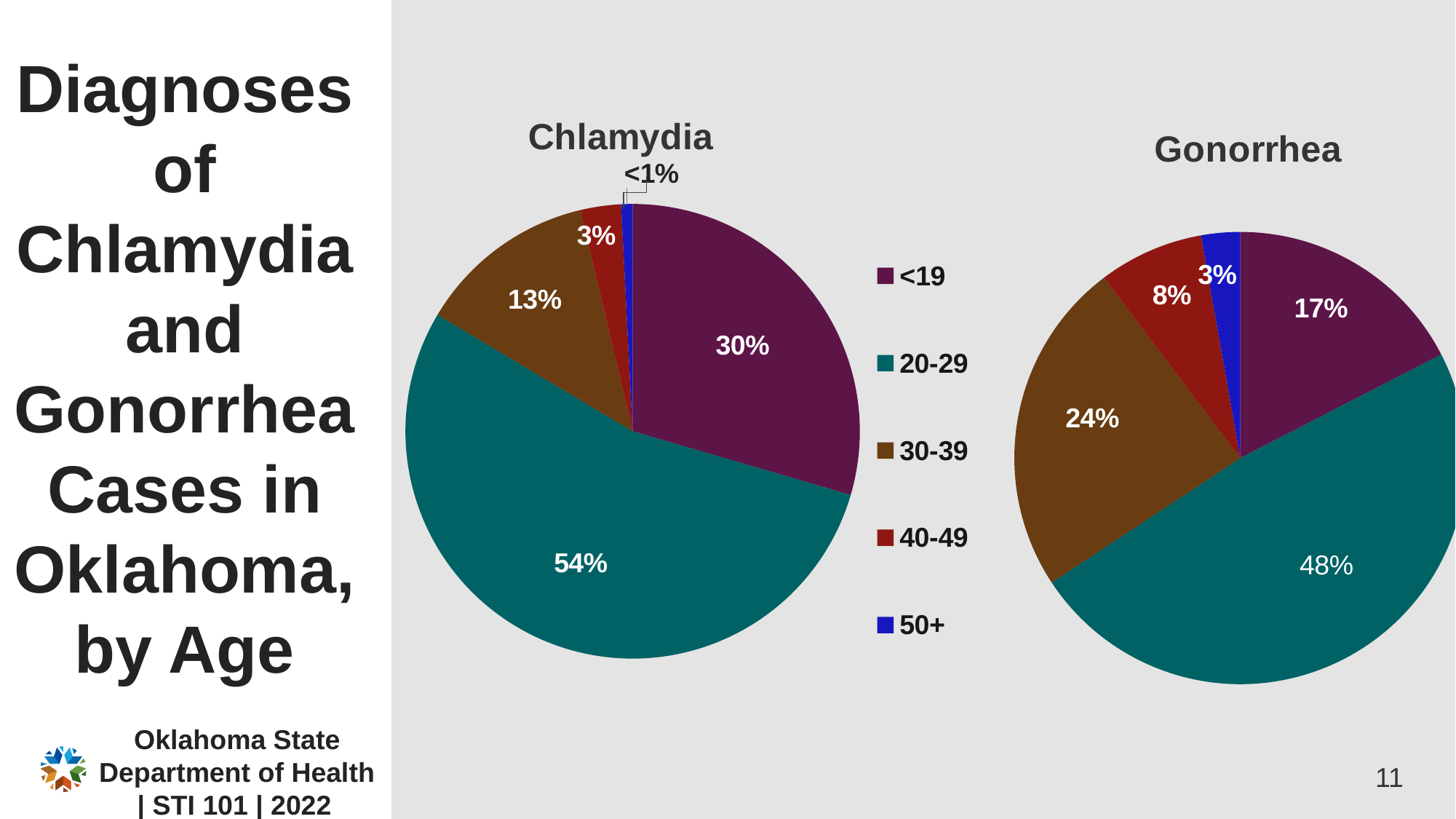
What is the difference between the 20-29 share in the Chlamydia chart and the 20-29 share in the Gonorrhea chart? 6 percentage points In the Gonorrhea pie chart, what share of cases is in the 40-49 age group? 8% Which colour represents the 30-39 age group in the legend? Brown How many age groups does the legend list? 5 In the Gonorrhea pie chart, which age group has the largest share? 20-29 In the Chlamydia pie chart, what share of cases is in the 50+ age group? <1% Which is larger: the <19 share in the Chlamydia chart or the <19 share in the Gonorrhea chart? Chlamydia In the Chlamydia pie chart, what share of cases is in the 20-29 age group? 54% What type of chart is used for the Chlamydia and Gonorrhea data? Pie chart In the Chlamydia pie chart, which age group has the smallest share? 50+ In the Gonorrhea pie chart, what share of cases is in the 30-39 age group? 24% In the Chlamydia pie chart, what share of cases is in the <19 age group? 30%